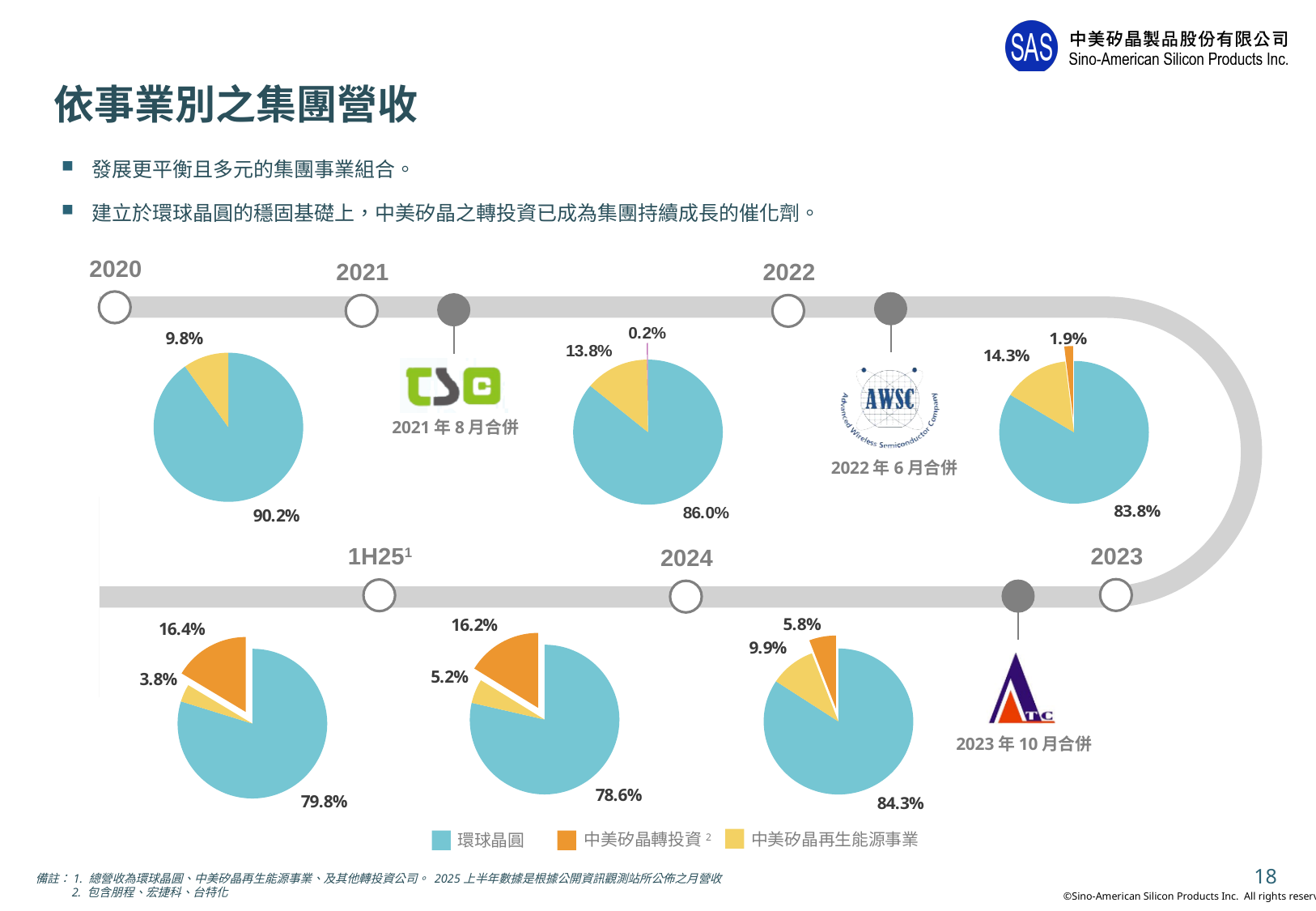
In the 2023 pie chart, what is the share of 中美矽晶轉投資? 5.8% In the 1H25 pie chart, which category has the largest share? 環球晶圓 How many pie charts are shown on the slide? 6 In the 2024 pie chart, which category has the smallest share? 中美矽晶再生能源事業 Which is larger: the share of 中美矽晶轉投資 in the 2024 pie chart or in the 1H25 pie chart? 1H25 How many series does the legend list? 3 In the 1H25 pie chart, what is the share of 中美矽晶再生能源事業? 3.8% In the 2020 pie chart, what share does 環球晶圓 hold? 90.2% In the 2021 pie chart, what is the share of 中美矽晶轉投資? 0.2% In the 2023 pie chart, what is the difference between the share of 中美矽晶再生能源事業 and the share of 中美矽晶轉投資? 4.1% In the 2024 pie chart, what is the share of 環球晶圓? 78.6% In the 2022 pie chart, what is the share of 中美矽晶再生能源事業? 14.3%